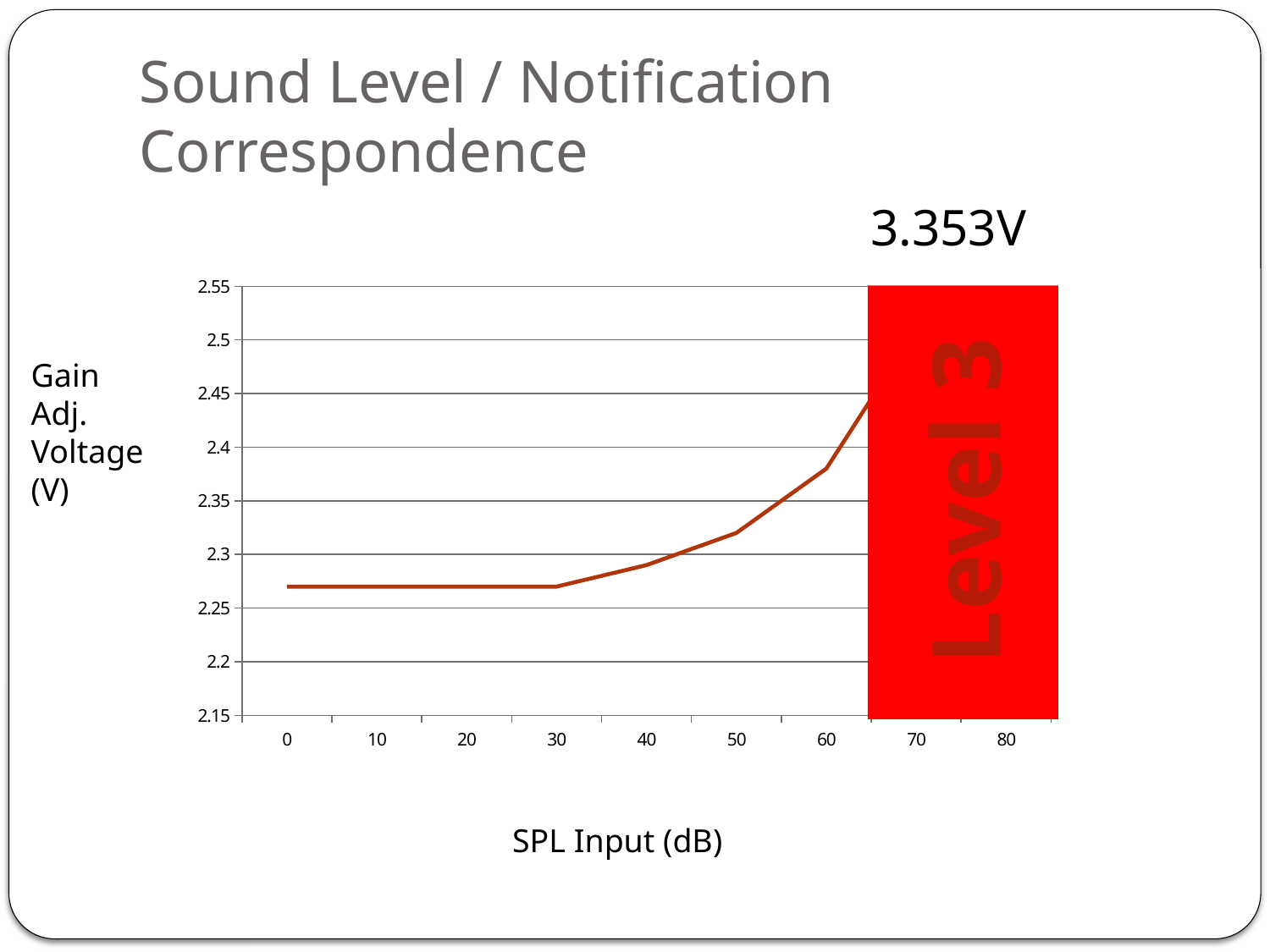
What kind of chart is shown on the slide? line chart Is the gain adjustment voltage at 20 dB greater or less than 2.25? greater Is the gain adjustment voltage at 60 dB greater or less than 2.35? greater What is the label of the y axis of the chart? Gain Adj. Voltage (V) What is the highest value shown on the y axis of the chart? 2.55 Is the gain adjustment voltage at 50 dB greater or less than 2.3? greater Which has the larger gain adjustment voltage, 20 dB or 60 dB SPL input? 60 dB What is the label of the x axis of the chart? SPL Input (dB) How many tick labels are shown on the x axis of the chart? 9 Does the gain adjustment voltage rise or fall as SPL input increases from 30 dB to 60 dB? rise